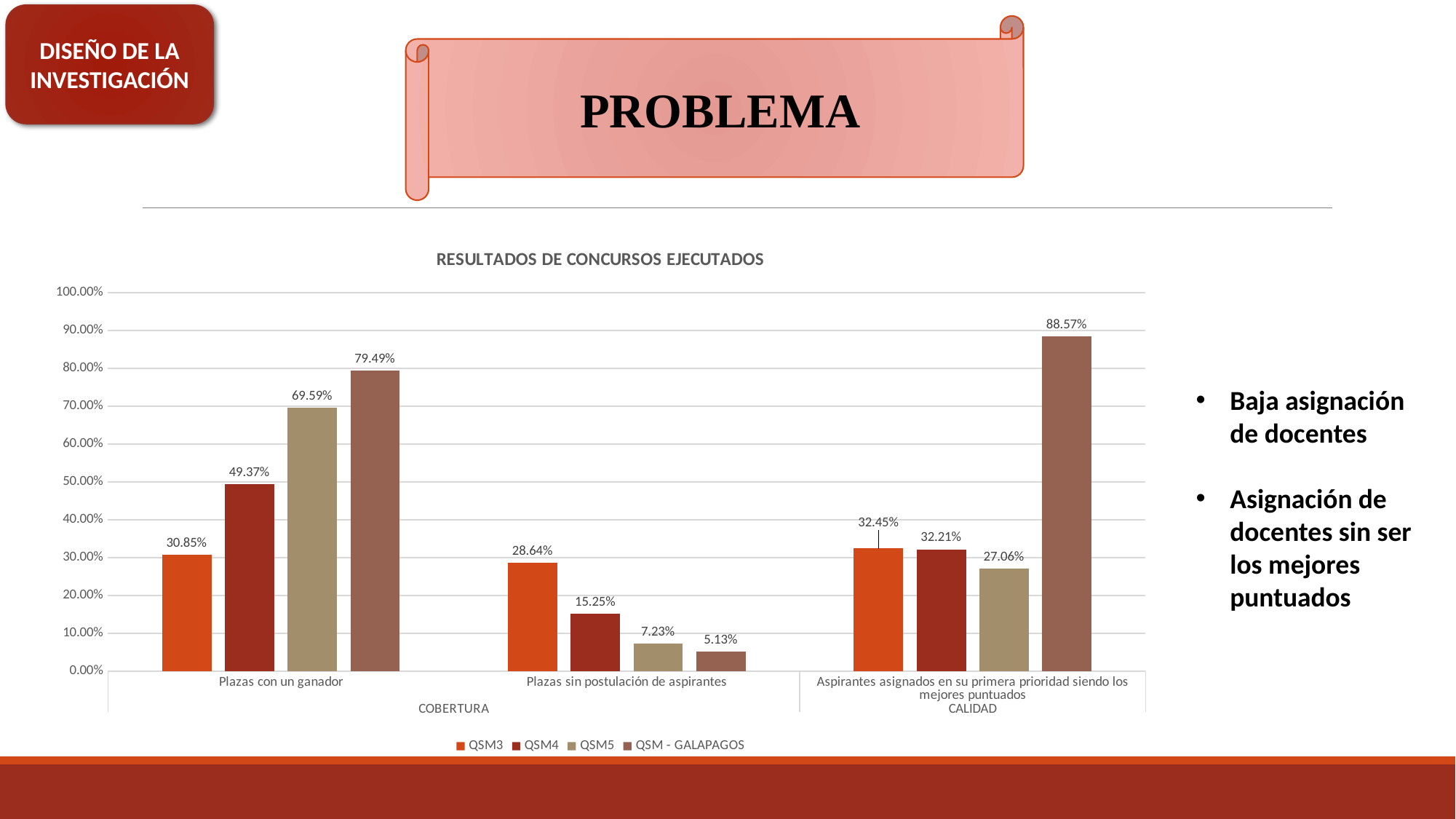
Which series has the lowest value in the category 'Plazas sin postulación de aspirantes'? QSM - GALAPAGOS What type of chart is shown on the slide? bar chart How many categories are shown on the x axis of the chart? 3 Which series is shown in orange in the chart legend? QSM3 In the category 'Plazas sin postulación de aspirantes', which is larger: the value for QSM3 or the value for QSM5? QSM3 Which series has the highest value in the category 'Aspirantes asignados en su primera prioridad siendo los mejores puntuados'? QSM - GALAPAGOS How many series does the chart legend list? 4 What is the value for QSM - GALAPAGOS in the category 'Plazas con un ganador'? 79.49% What is the value for QSM4 in the category 'Plazas sin postulación de aspirantes'? 15.25% What is the title of the chart? RESULTADOS DE CONCURSOS EJECUTADOS What is the difference between the QSM5 and QSM3 values in the category 'Plazas con un ganador'? 38.74% What is the value for QSM5 in the category 'Aspirantes asignados en su primera prioridad siendo los mejores puntuados'? 27.06%